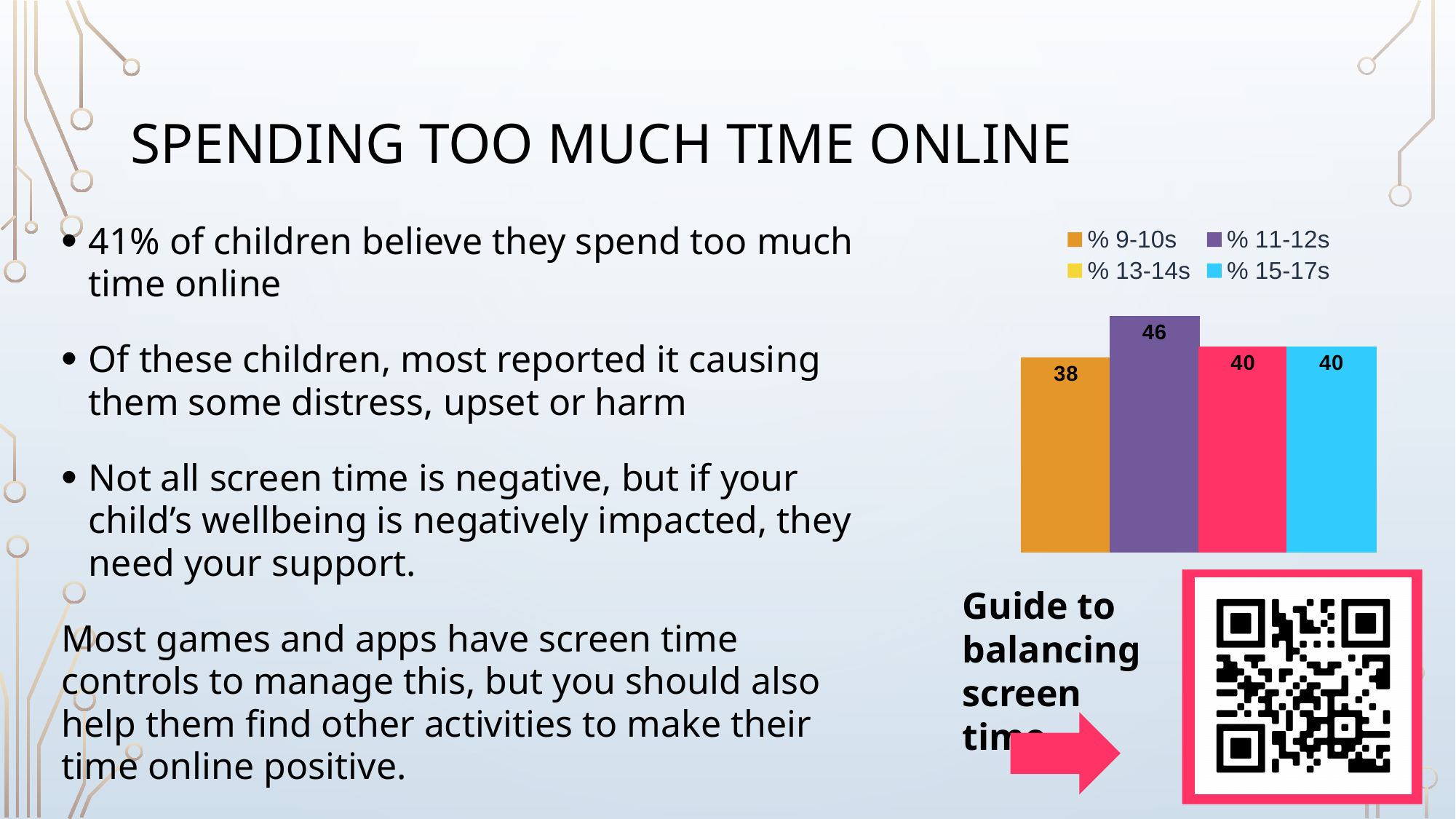
What value is shown for the % 11-12s series in the chart? 46 Which is larger, the value for % 9-10s or the value for % 15-17s? % 15-17s How many series does the chart legend list? 4 Which age group has the lowest value in the chart? % 9-10s How many bars are plotted in the chart? 4 What value is shown for the % 9-10s series in the chart? 38 What is the difference between the values for % 11-12s and % 15-17s? 6 What type of chart is shown on the slide? bar chart What is the difference between the values for % 11-12s and % 9-10s? 8 What value is shown for the % 15-17s series in the chart? 40 Which series is shown in orange in the chart legend? % 9-10s Which age group has the highest value in the chart? % 11-12s